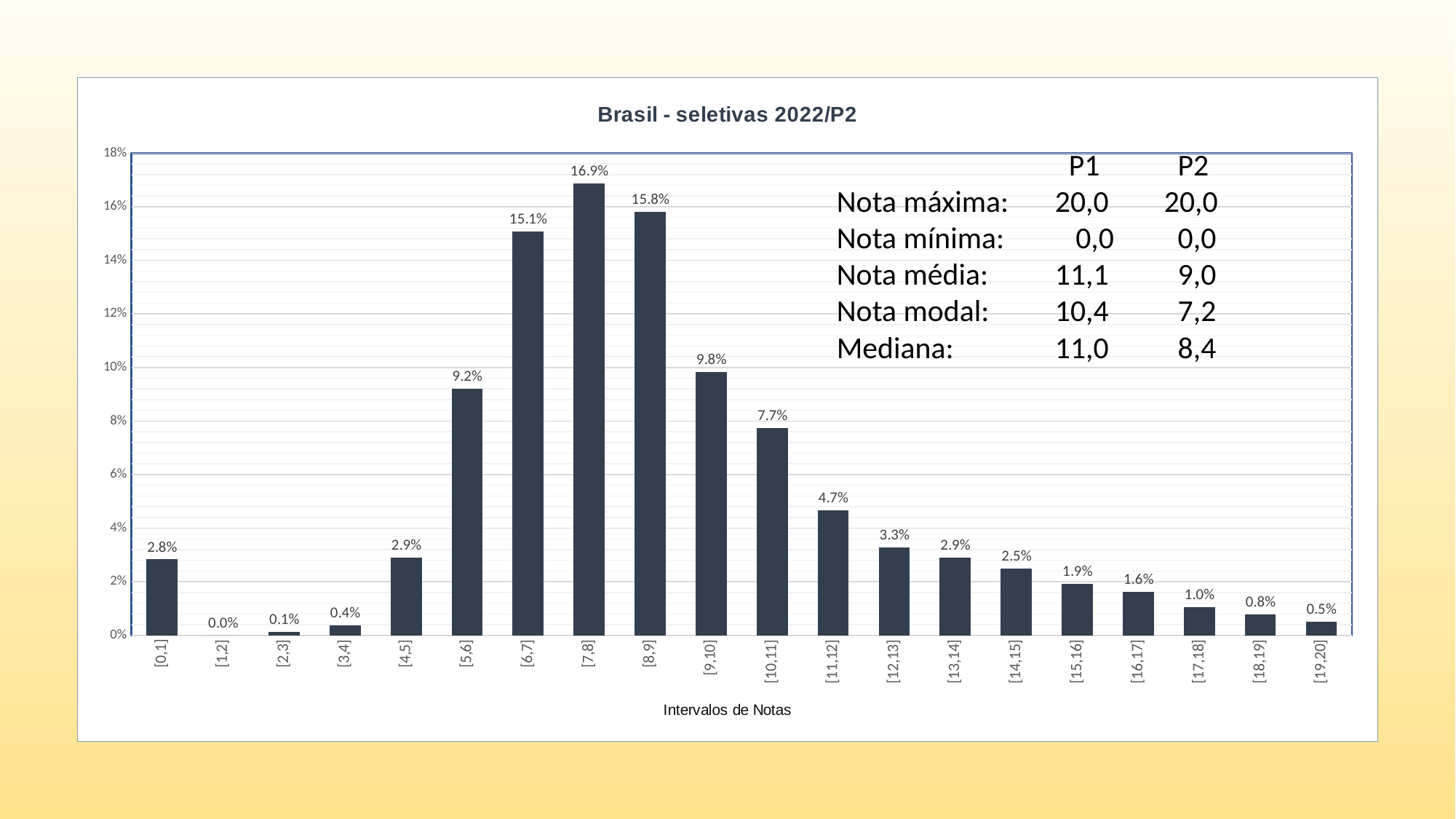
What is the value for the [7,8] interval? 16.9% Do the values rise or fall from [8,9] to [19,20]? fall How many intervals are shown on the x axis? 20 Which is larger, the value for [5,6] or the value for [9,10]? [9,10] What is the value for the [10,11] interval? 7.7% Is the value for [6,7] greater or less than 14%? greater Which interval has the highest value? [7,8] What is the value for the [19,20] interval? 0.5% Which interval has the lowest value? [1,2] What is the title of the chart? Brasil - seletivas 2022/P2 What is the difference between the values for [7,8] and [8,9]? 1.1% What kind of chart is this? bar chart